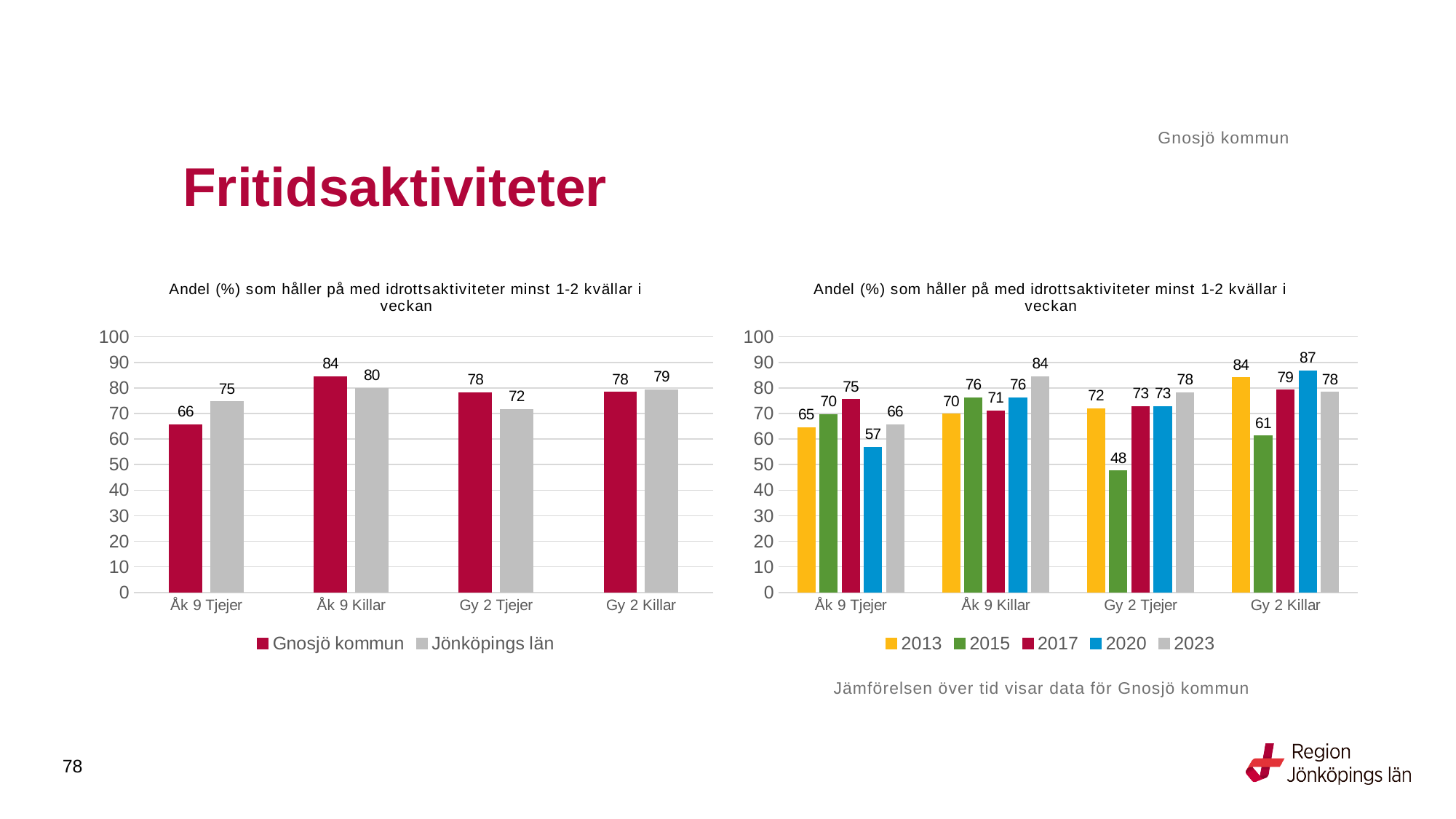
In the left chart, what is the value for Jönköpings län for Gy 2 Tjejer? 72 In the right chart, what is the value for 2020 for Åk 9 Tjejer? 57 How many series does the legend of the right chart list? 5 In the right chart, what is the difference between 2023 and 2013 for Åk 9 Killar? 14 What kind of chart is the right chart? Bar chart In the left chart, which category has the highest value for Gnosjö kommun? Åk 9 Killar In the right chart, which year has the highest value for Gy 2 Killar? 2020 In the left chart, which is larger for Gy 2 Tjejer: Gnosjö kommun or Jönköpings län? Gnosjö kommun In the right chart, what is the value for 2015 for Gy 2 Tjejer? 48 How many series does the legend of the left chart list? 2 In the left chart, what is the difference between Gnosjö kommun and Jönköpings län for Åk 9 Tjejer? 9 In the left chart, what is the value for Gnosjö kommun for Åk 9 Tjejer? 66